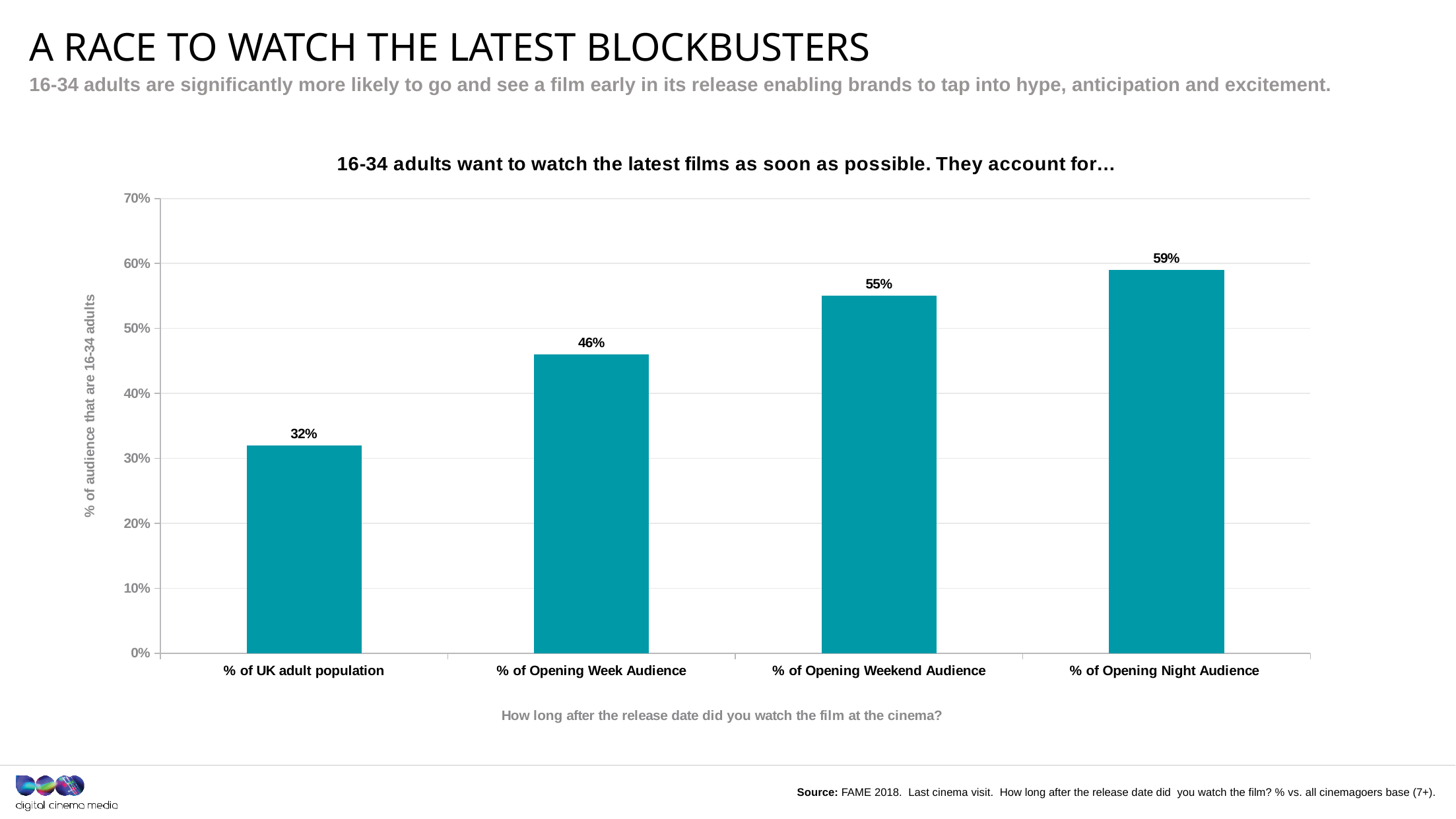
What is the value for % of Opening Weekend Audience? 55% What kind of chart is shown on the slide? bar chart What is the value for % of Opening Night Audience? 59% Which is larger: the value for % of Opening Week Audience or the value for % of Opening Weekend Audience? % of Opening Weekend Audience Is the value for % of Opening Week Audience greater or less than 50%? less What is the difference between the value for % of Opening Night Audience and the value for % of UK adult population? 27% Do the values rise or fall from left to right along the x axis? rise What is the value for % of Opening Week Audience? 46% What is the value for % of UK adult population? 32% Which category has the lowest value? % of UK adult population Which category has the highest value? % of Opening Night Audience How many categories are shown on the x axis? 4